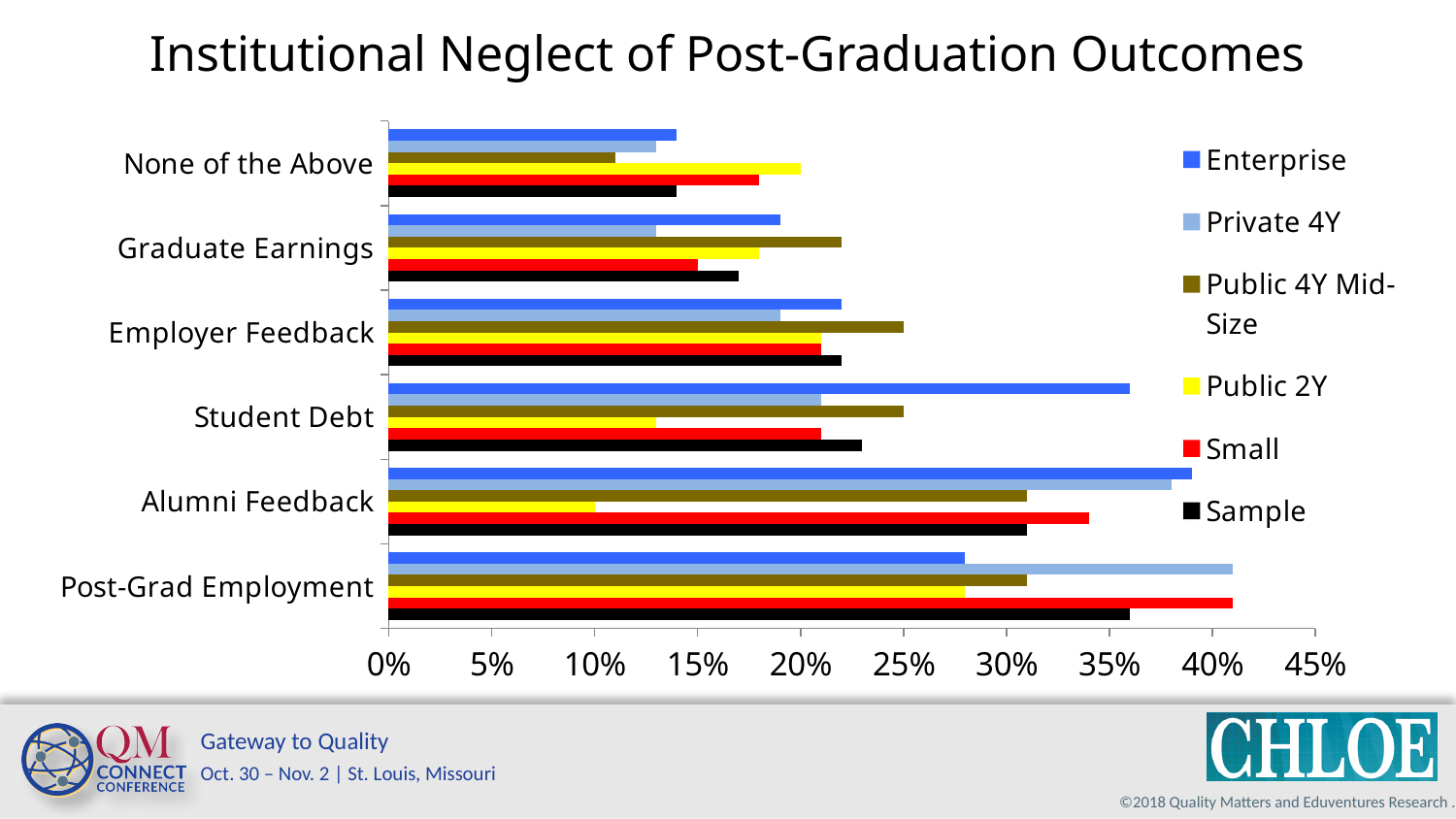
For Alumni Feedback, which is larger: the Enterprise value or the Public 2Y value? Enterprise Which category has the lowest Sample value? None of the Above Is the Public 2Y value for Alumni Feedback greater or less than 15%? less Is the Enterprise value for Student Debt greater or less than 30%? greater What kind of chart is shown on the slide? Bar chart For Student Debt, which is larger: the Enterprise value or the Private 4Y value? Enterprise Is the Private 4Y value for Post-Grad Employment greater or less than 35%? greater Which category has the highest Public 2Y value? Post-Grad Employment How many categories are shown on the vertical axis of the chart? 6 How many series does the legend list? 6 What is the title of the chart? Institutional Neglect of Post-Graduation Outcomes